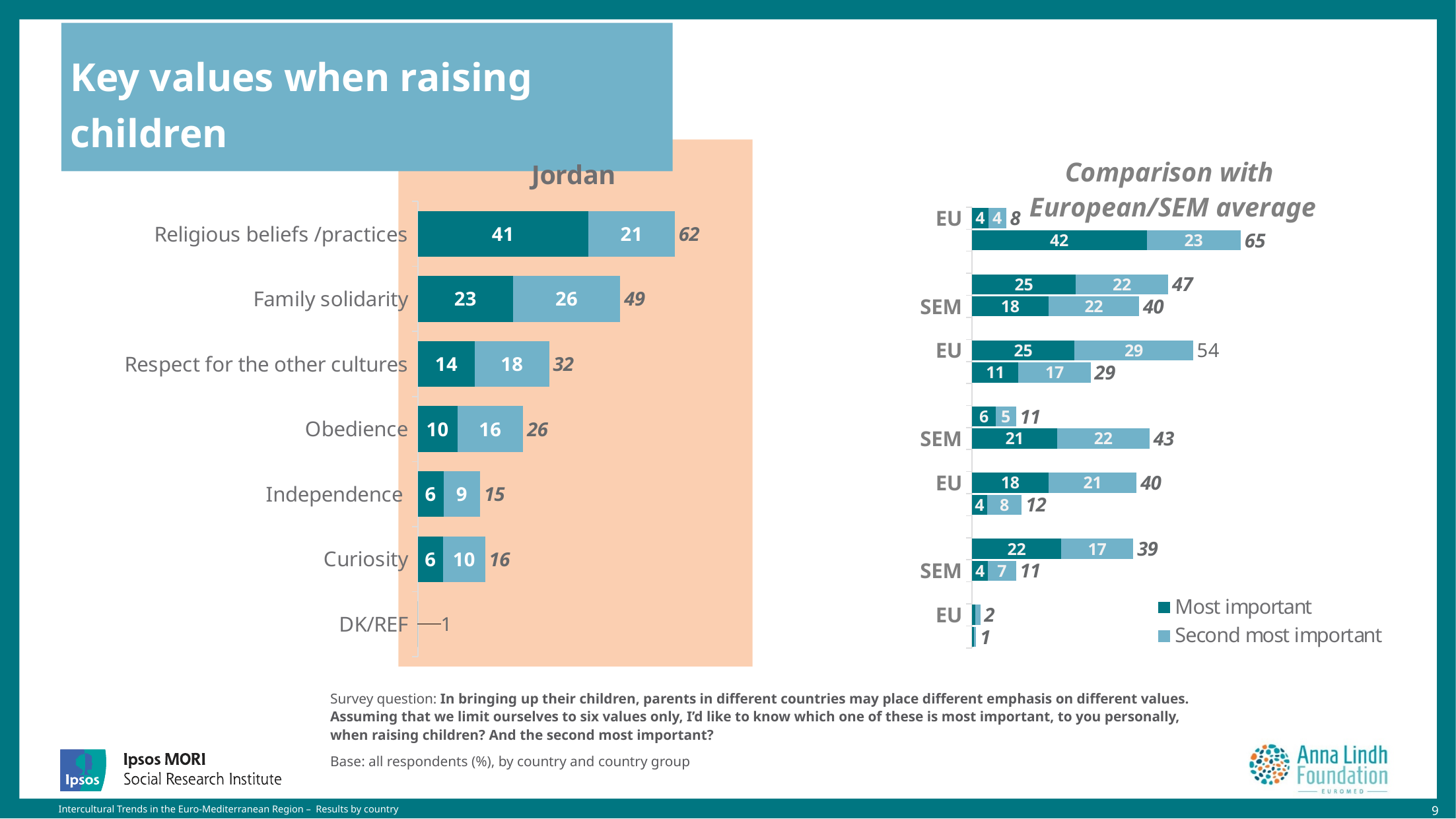
In the Jordan chart, what is the difference between the totals for Family solidarity and Obedience? 23 In the Jordan chart, what is the 'Second most important' value for Family solidarity? 26 In the Jordan chart, what is the total for Respect for the other cultures? 32 In the Jordan chart, what is the 'Most important' value for Religious beliefs /practices? 41 In the Jordan chart, what is the 'Most important' value for Obedience? 10 How many categories are shown in the Jordan chart? 7 How many series does the legend list? 2 In the Jordan chart, which category has the lowest total? DK/REF In the Jordan chart, which is larger: the total for Curiosity or the total for Independence? Curiosity What kind of chart is the Jordan chart? Stacked bar chart What is the title of the chart on the right of the slide? Comparison with European/SEM average In the Jordan chart, which category has the highest total? Religious beliefs /practices